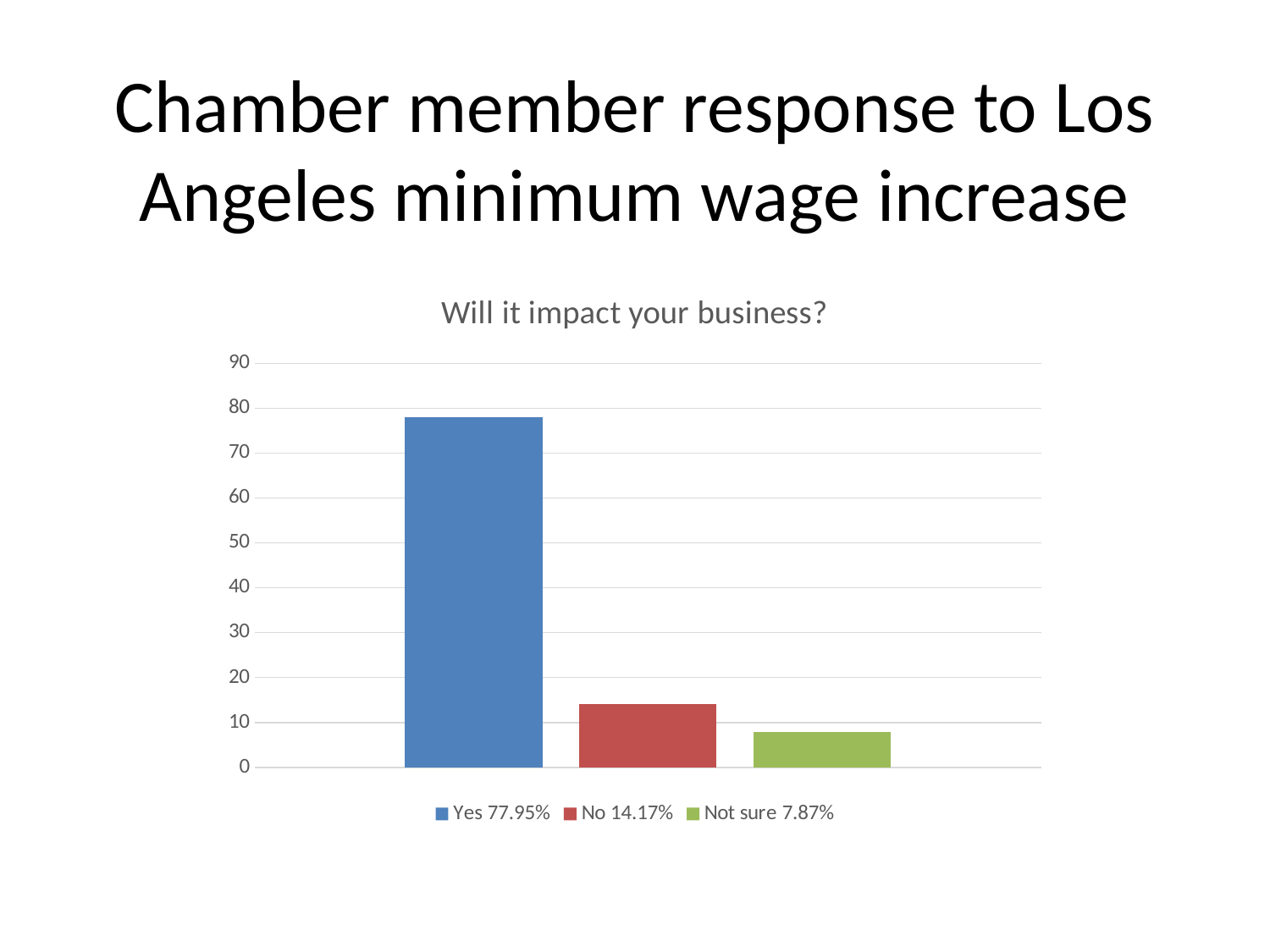
Which response has the lowest share of respondents? Not sure What is the difference between the Yes share and the No share? 63.78% What percentage of chamber members answered Yes to whether the minimum wage increase will impact their business? 77.95% What percentage of respondents answered Not sure? 7.87% Which response has the highest share of respondents? Yes Is the value for the Yes bar greater or less than 70? greater Is the value for the Not sure bar greater or less than 10? less How many bars are plotted in the chart? 3 What type of chart is shown on the slide? Bar chart What is the title of the chart? Will it impact your business? Which is larger, the share answering No or the share answering Not sure? No What percentage of respondents answered No? 14.17%